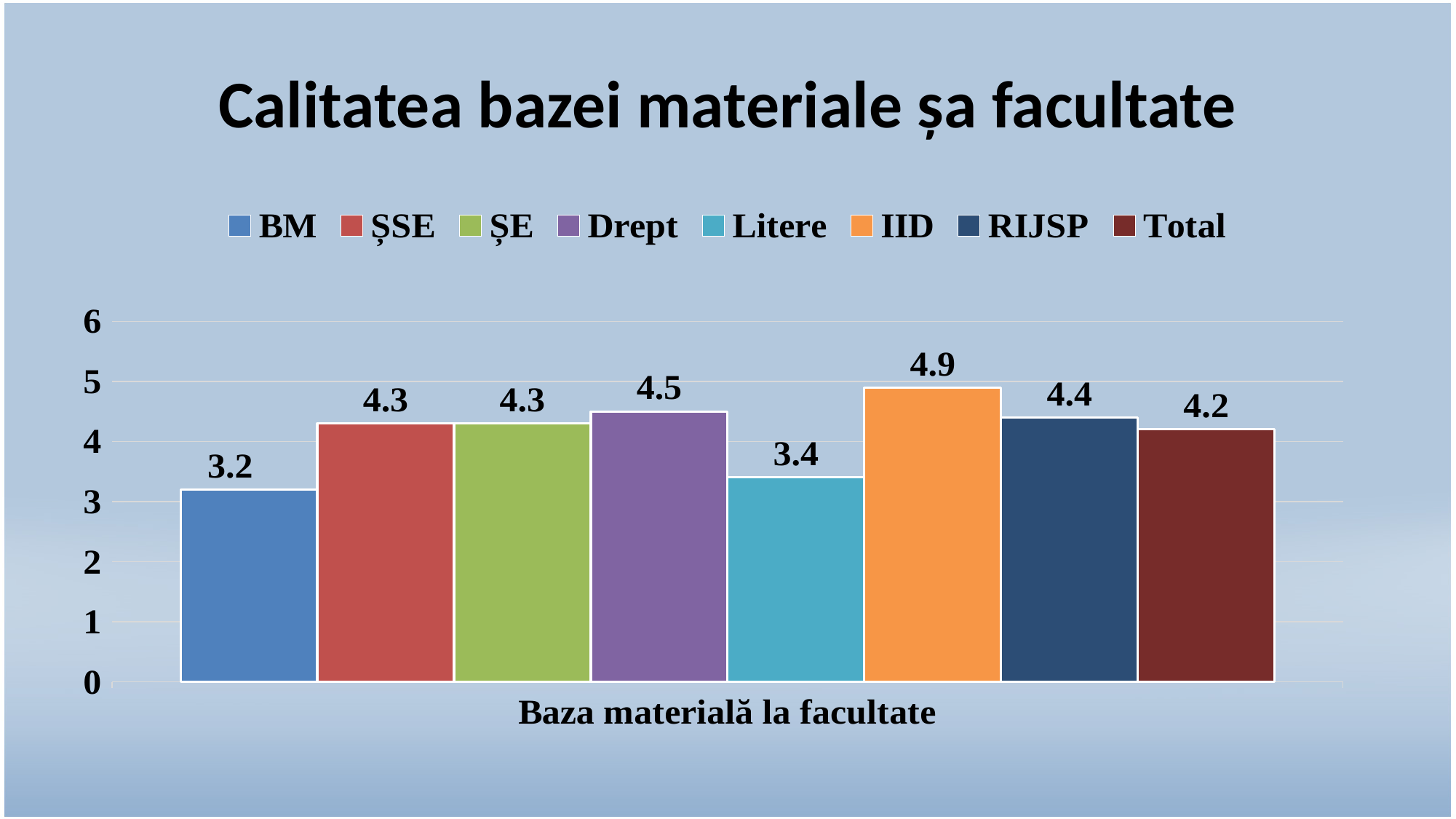
Which series has the lowest value? BM What is the value for IID? 4.9 What is the value for Total? 4.2 What is the value for Litere? 3.4 What is the value for BM? 3.2 What is the title of the chart? Calitatea bazei materiale șa facultate How many series does the legend list? 8 Which is larger, the value for Drept or the value for RIJSP? Drept What is the difference between the values for IID and BM? 1.7 What kind of chart is shown on the slide? bar chart Which series has the highest value? IID Is the value for Litere greater or less than 4? less